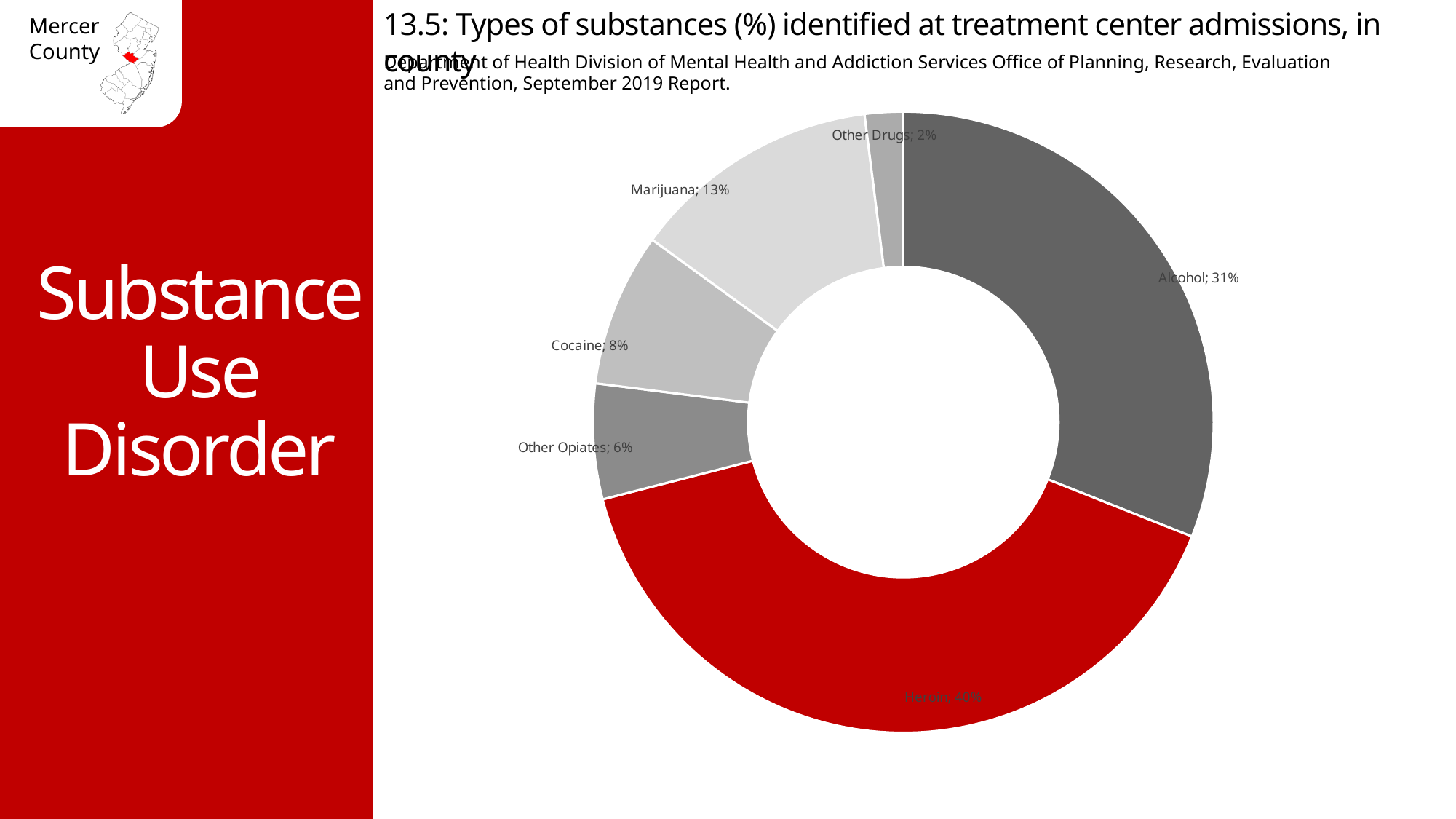
What percentage of treatment center admissions identified Alcohol? 31% How many substance categories are shown in the chart? 6 What percentage is shown for Marijuana? 13% What is the difference between the Heroin and Alcohol percentages? 9% What kind of chart is shown on the slide? Doughnut (pie) chart Which substance has the largest share of the chart? Heroin Which substance has the smallest share of the chart? Other Drugs Which is larger, the share for Cocaine or the share for Other Opiates? Cocaine What percentage is shown for Heroin? 40% Which slice of the chart is coloured red? Heroin What percentage is shown for Cocaine? 8% What percentage is shown for Other Opiates? 6%